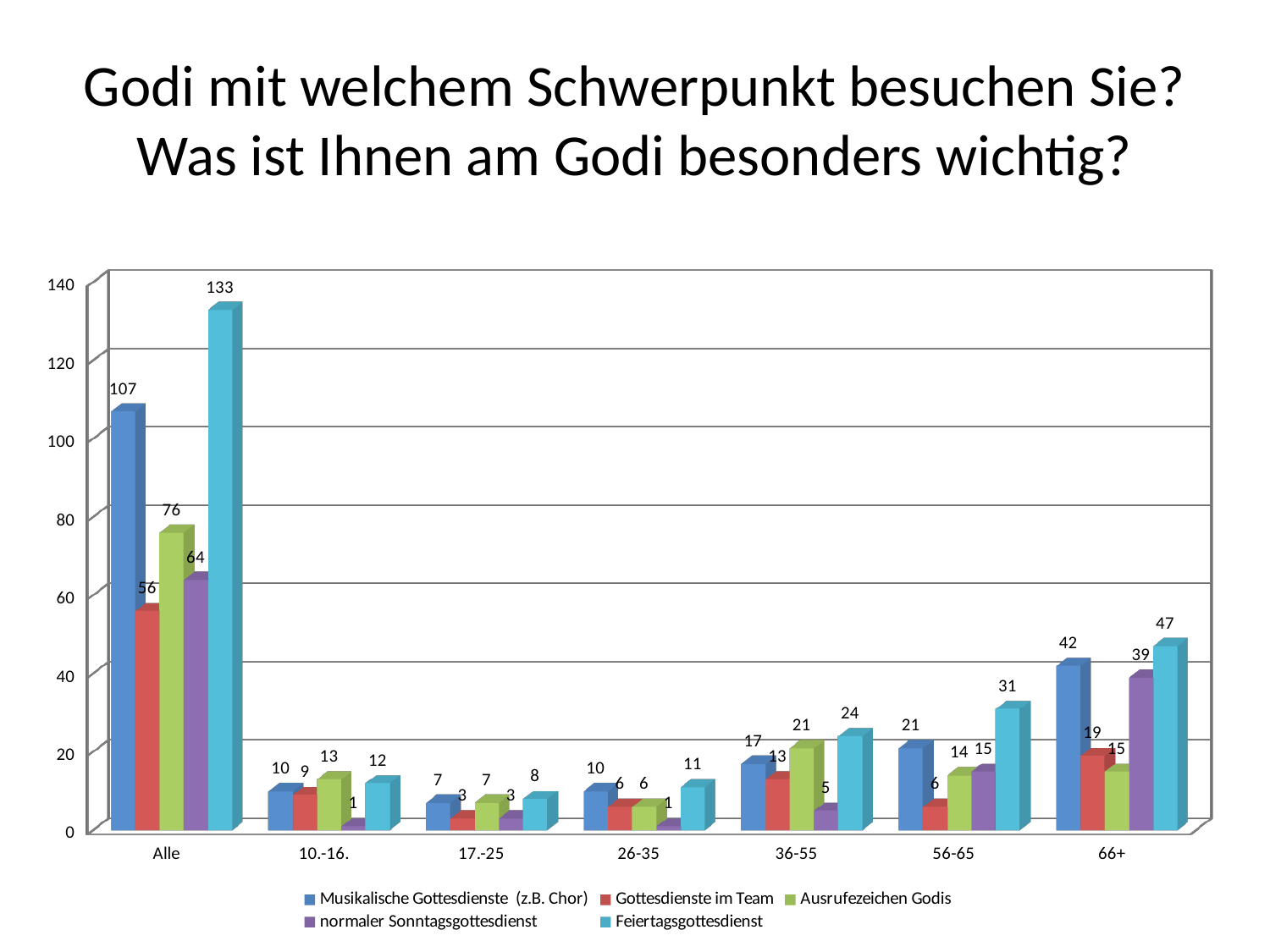
What is the value for Feiertagsgottesdienst in the Alle category? 133 In the 66+ category, which is larger: Gottesdienste im Team or normaler Sonntagsgottesdienst? normaler Sonntagsgottesdienst How many series does the legend list? 5 Which series has the highest value in the Alle category? Feiertagsgottesdienst Which age group has the highest value for Feiertagsgottesdienst, excluding Alle? 66+ How many categories are shown on the x axis? 7 What is the value for Musikalische Gottesdienste (z.B. Chor) in the 66+ category? 42 What is the value for normaler Sonntagsgottesdienst in the 56-65 category? 15 Which series has the lowest value in the 36-55 category? normaler Sonntagsgottesdienst What is the difference between Feiertagsgottesdienst and Musikalische Gottesdienste (z.B. Chor) in the Alle category? 26 What kind of chart is shown on the slide? Bar chart Is the value for Ausrufezeichen Godis in the Alle category greater or less than 60? greater